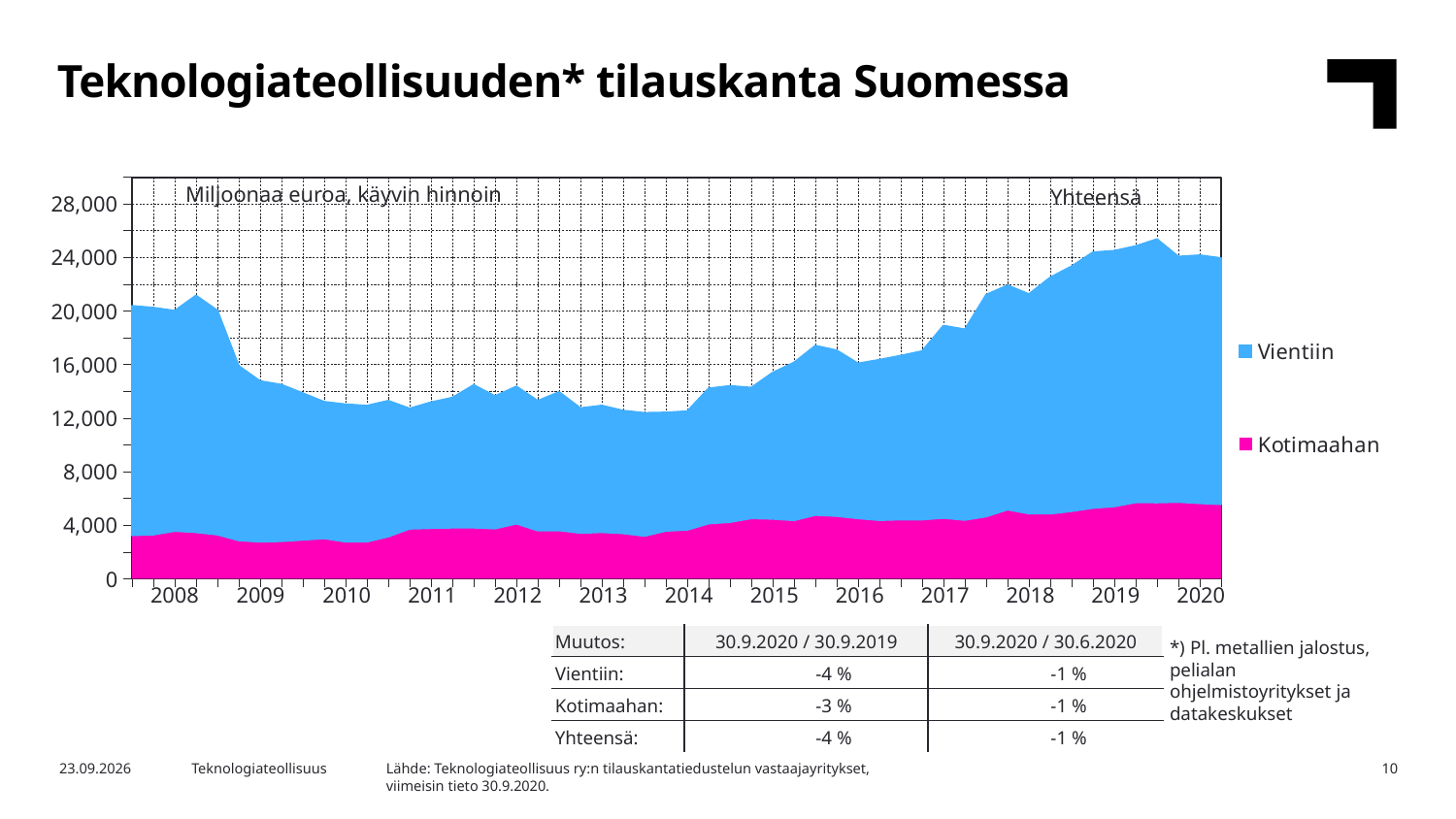
Which two series are listed in the chart legend? Vientiin and Kotimaahan What unit label is shown at the top left of the chart area? Miljoonaa euroa, käyvin hinnoin How many years are labeled on the x axis of the chart? 13 Is the total order backlog (Yhteensä) in 2020 greater or less than 20,000? greater How many series does the chart legend list? 2 Is the Kotimaahan value in 2020 greater or less than 4,000? greater What kind of chart is shown on the slide? Stacked area chart Which is larger, the total order backlog in 2020 or in 2010? 2020 Does the total order backlog rise or fall between 2014 and 2019? rise Does the total order backlog rise or fall between 2008 and 2010? fall Is the Kotimaahan value in 2009 greater or less than 4,000? less